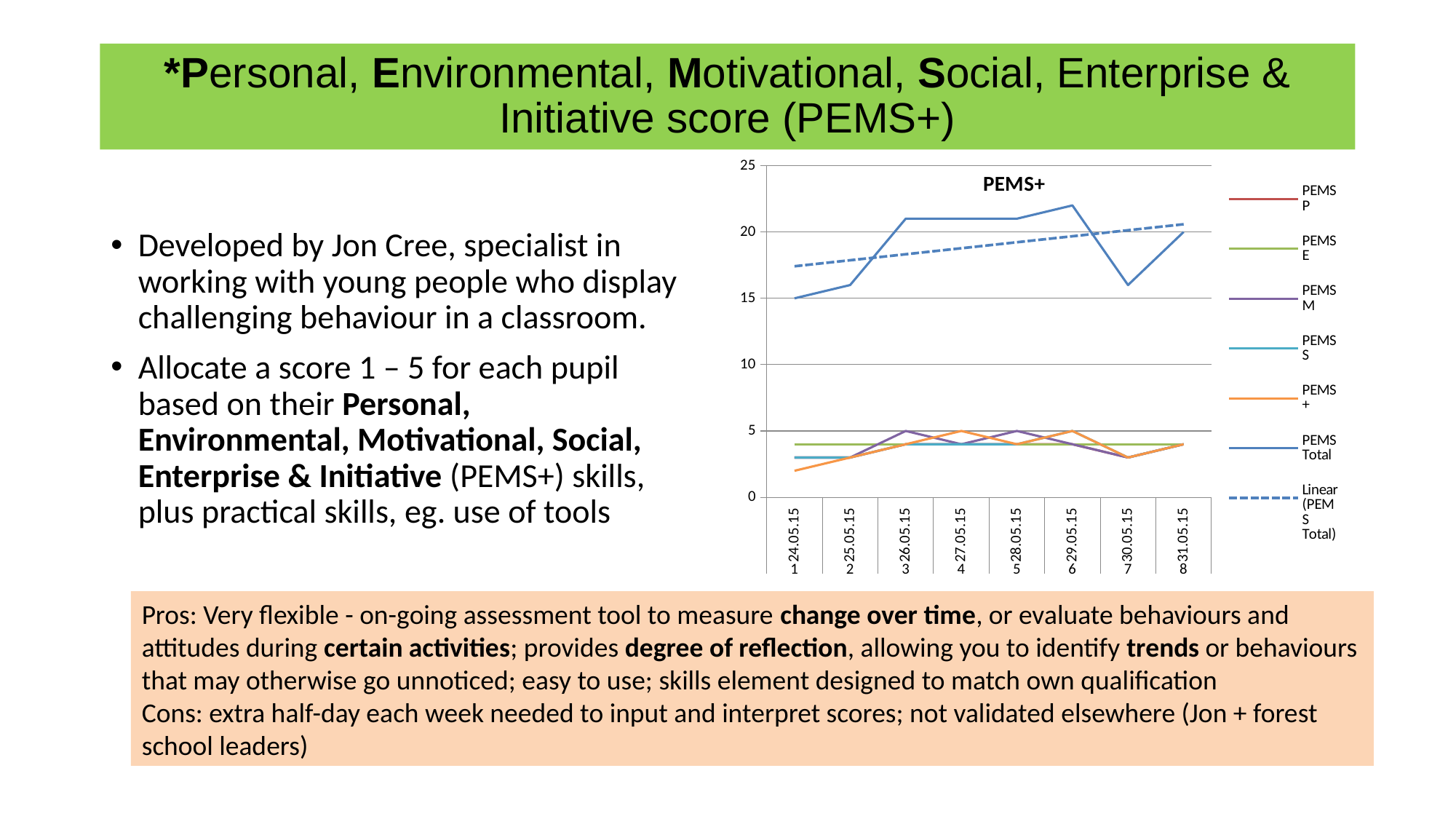
Which is larger, the PEMS Total value on 29.05.15 or on 30.05.15? 29.05.15 Is the PEMS Total value on 30.05.15 greater or less than 20? less How many dates are plotted along the x axis of the chart? 8 What kind of chart is shown on the slide? line chart Is the PEMS + value on 24.05.15 greater or less than 5? less Which legend entry is drawn as a dashed line? Linear (PEMS Total) Is the PEMS Total value on 29.05.15 greater or less than 20? greater What is the title of the chart? PEMS+ What is the PEMS Total value on 24.05.15? 15 Does the Linear (PEMS Total) trendline rise or fall from left to right? rise On which date is the PEMS Total value highest? 29.05.15 How many series does the chart legend list? 7